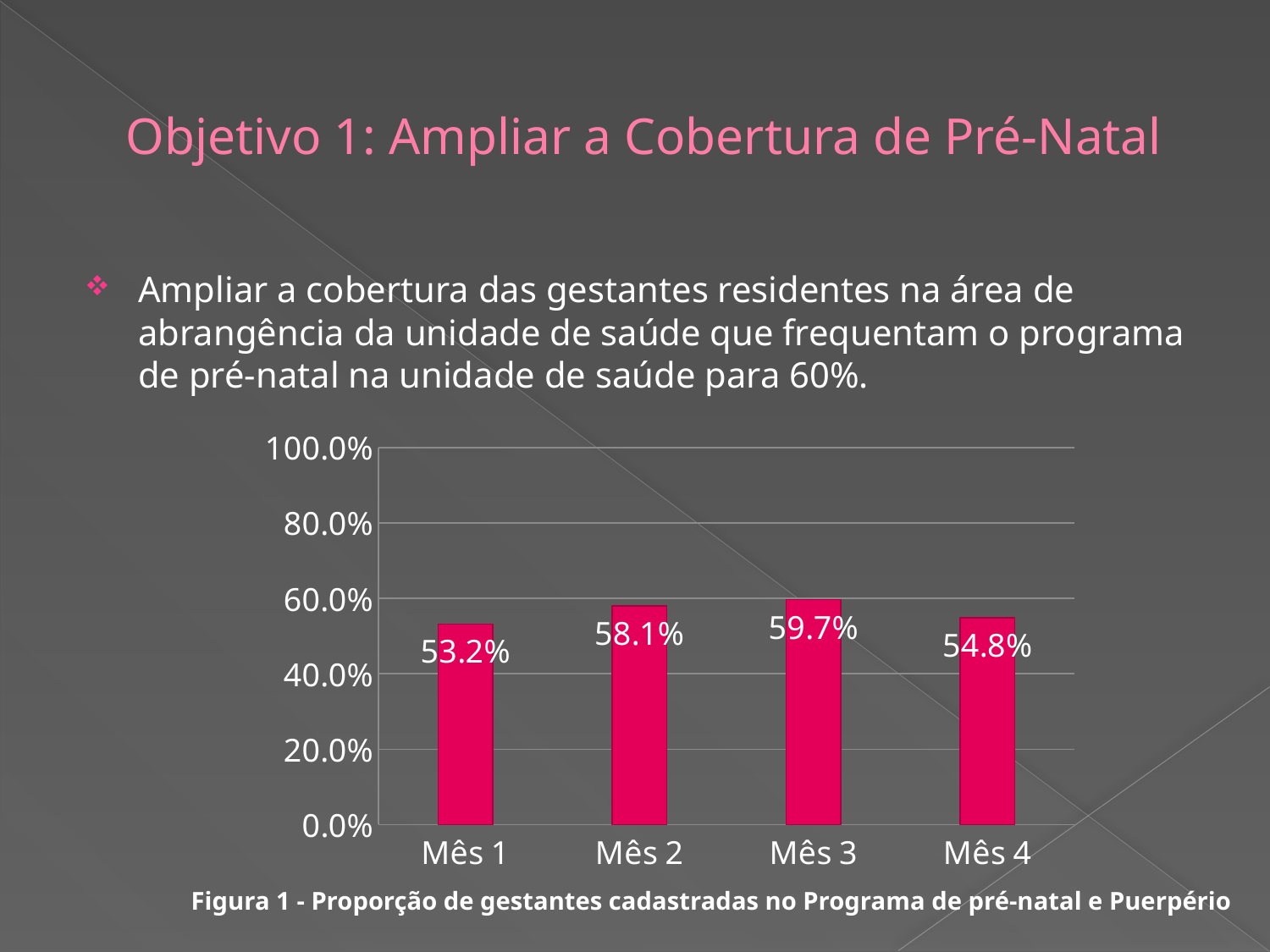
How many months are shown on the x axis? 4 What is the value for Mês 1? 53.2% Which is larger, the value for Mês 2 or the value for Mês 4? Mês 2 Is the value for Mês 3 greater or less than 80.0%? less What is the value for Mês 3? 59.7% What kind of chart is shown on the slide? bar chart What is the difference between the values for Mês 2 and Mês 4? 3.3% Which month has the lowest value? Mês 1 What is the caption of the figure below the chart? Figura 1 - Proporção de gestantes cadastradas no Programa de pré-natal e Puerpério What is the value for Mês 4? 54.8% Which month has the highest value? Mês 3 What is the difference between the values for Mês 3 and Mês 1? 6.5%